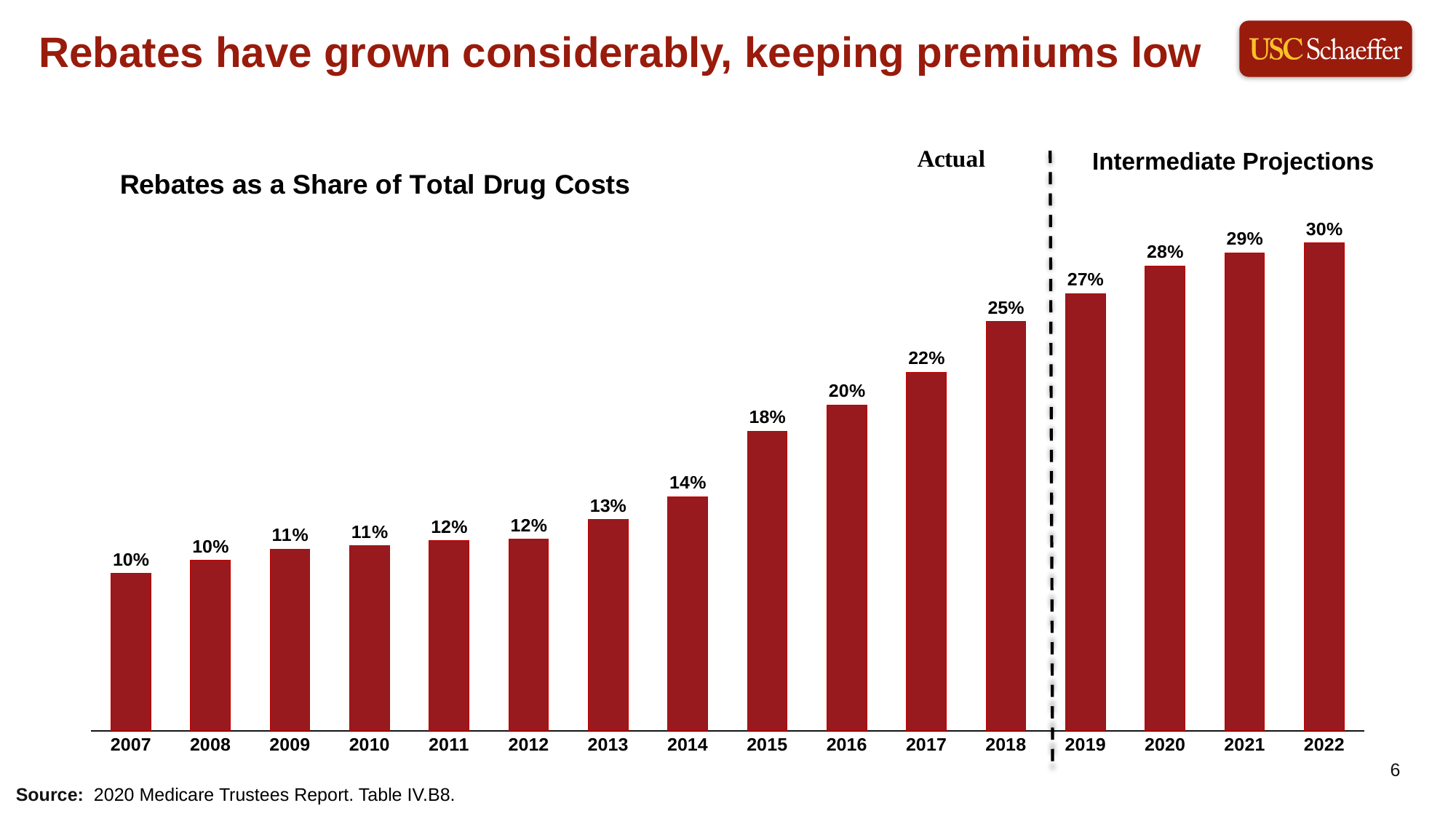
What is the title of the chart? Rebates as a Share of Total Drug Costs What is the difference between the values for 2018 and 2007? 15% What label is given to the years to the right of the dashed line? Intermediate Projections What is the value for 2022? 30% Which year has the highest value? 2022 What is the value for 2007? 10% What is the value for 2015? 18% Which is larger, the value for 2013 or the value for 2017? 2017 What kind of chart is this? Bar chart How many years are shown on the x axis? 16 What is the difference between the values for 2019 and 2016? 7% Do the values rise or fall from 2007 to 2022? Rise